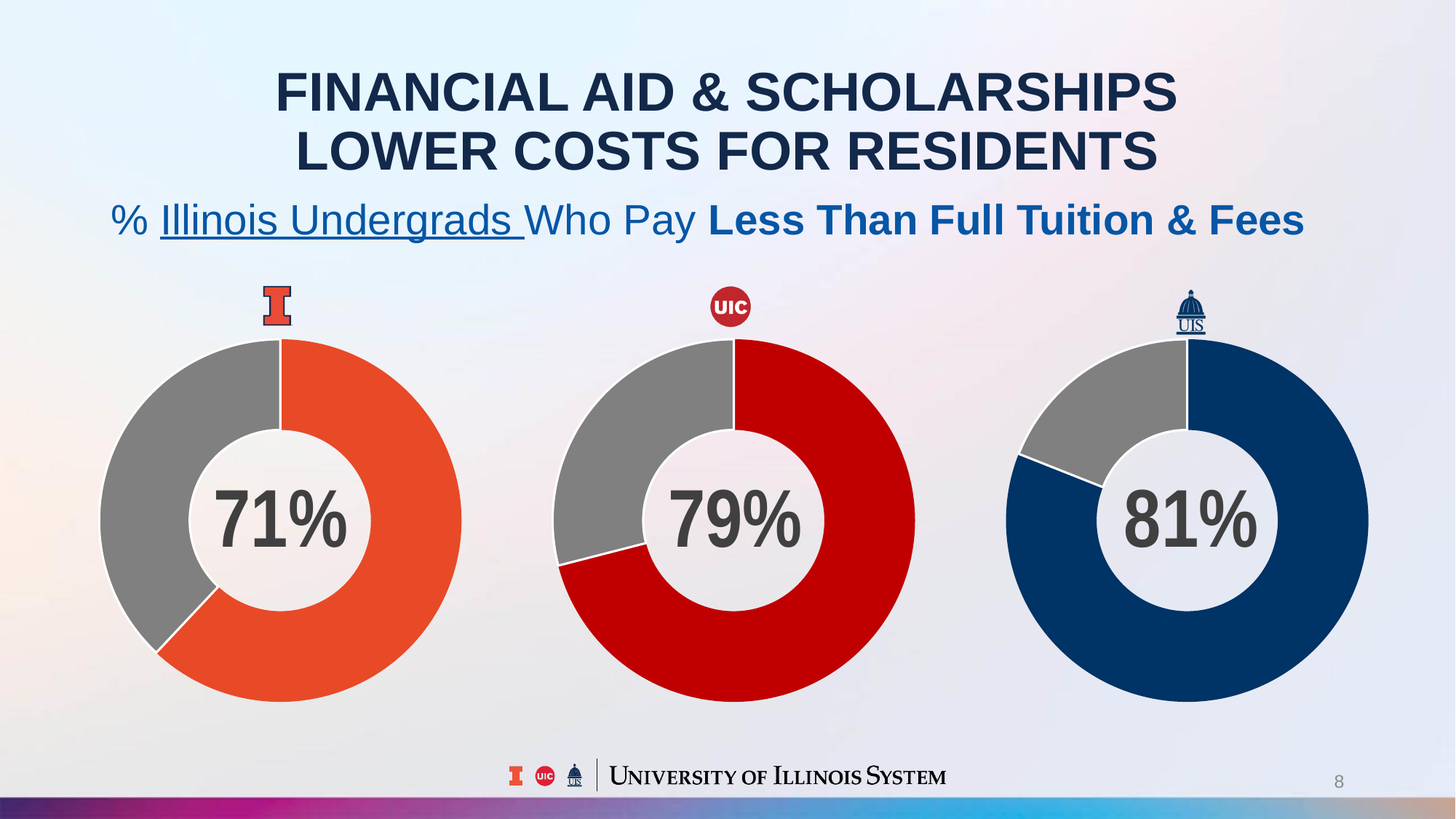
What percentage is shown in the centre of the UIS donut chart? 81% Which is larger, the UIC percentage or the left (Block I) chart's percentage? UIC What is the difference between the UIC percentage and the left (Block I) chart's percentage? 8 percentage points In the UIS donut chart, what share of the ring is the grey remainder? 19% What percentage is shown in the centre of the UIC donut chart? 79% What kind of chart is used to show the percentages on this slide? Donut (pie) chart Which of the three donut charts shows the highest percentage? UIS (81%) What percentage is shown in the centre of the left donut chart (Block I logo)? 71% How many donut charts are on the slide? 3 What is the difference between the UIS percentage and the UIC percentage? 2 percentage points What does the subtitle say the donut charts measure? % Illinois Undergrads Who Pay Less Than Full Tuition & Fees Which of the three donut charts shows the lowest percentage? The left chart with the Block I logo (71%)